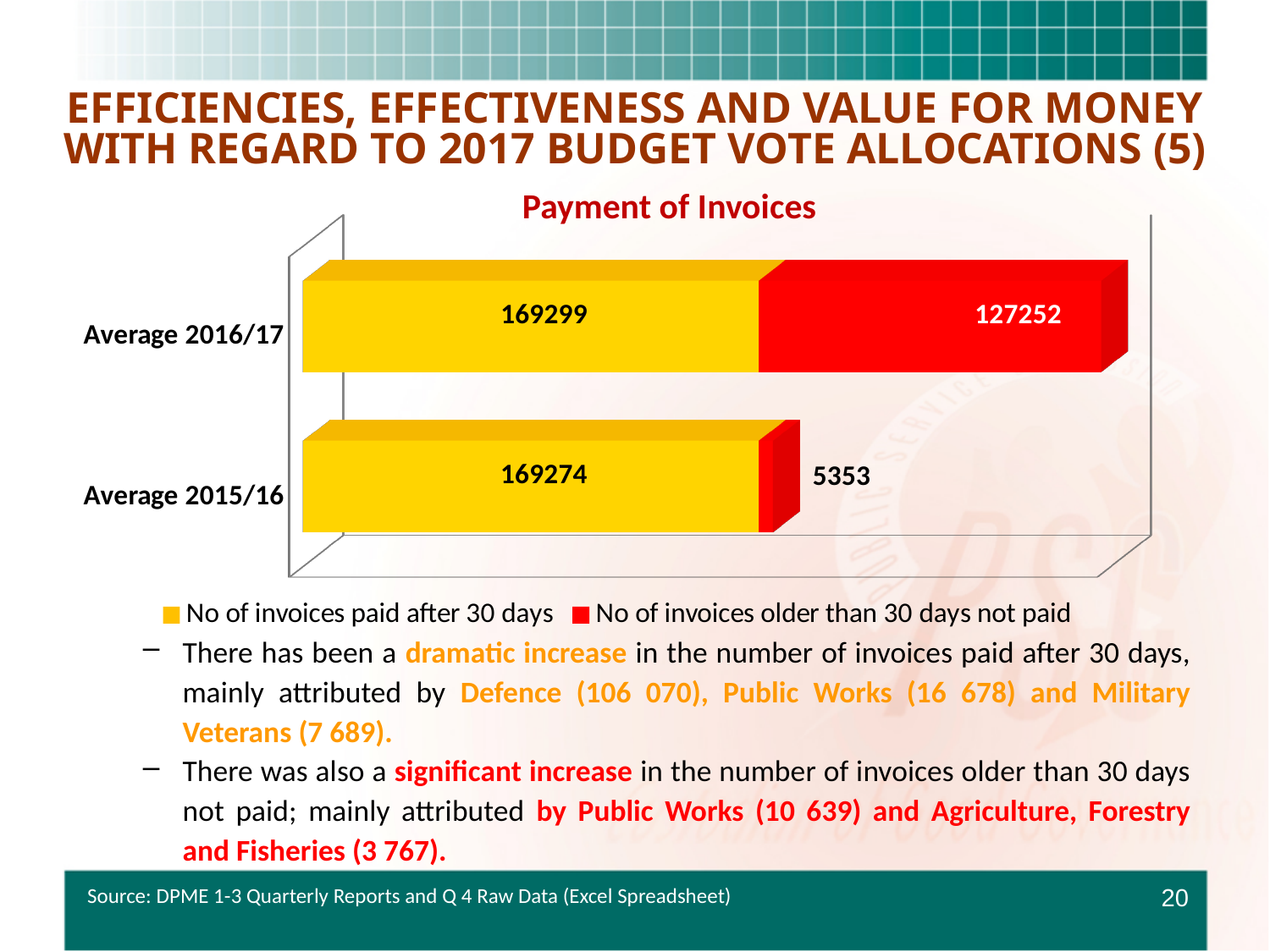
How many series does the chart legend list? 2 What is the difference in the number of invoices older than 30 days not paid between Average 2016/17 and Average 2015/16? 121899 What is the number of invoices older than 30 days not paid for Average 2015/16? 5353 What is the number of invoices paid after 30 days for Average 2015/16? 169274 What is the title of the chart? Payment of Invoices What is the total of the stacked bar for Average 2016/17? 296551 What is the total of the stacked bar for Average 2015/16? 174627 What is the number of invoices older than 30 days not paid for Average 2016/17? 127252 What is the number of invoices paid after 30 days for Average 2016/17? 169299 What type of chart is shown on the slide? Stacked bar chart How many categories are shown on the chart? 2 Which category has the higher number of invoices older than 30 days not paid? Average 2016/17